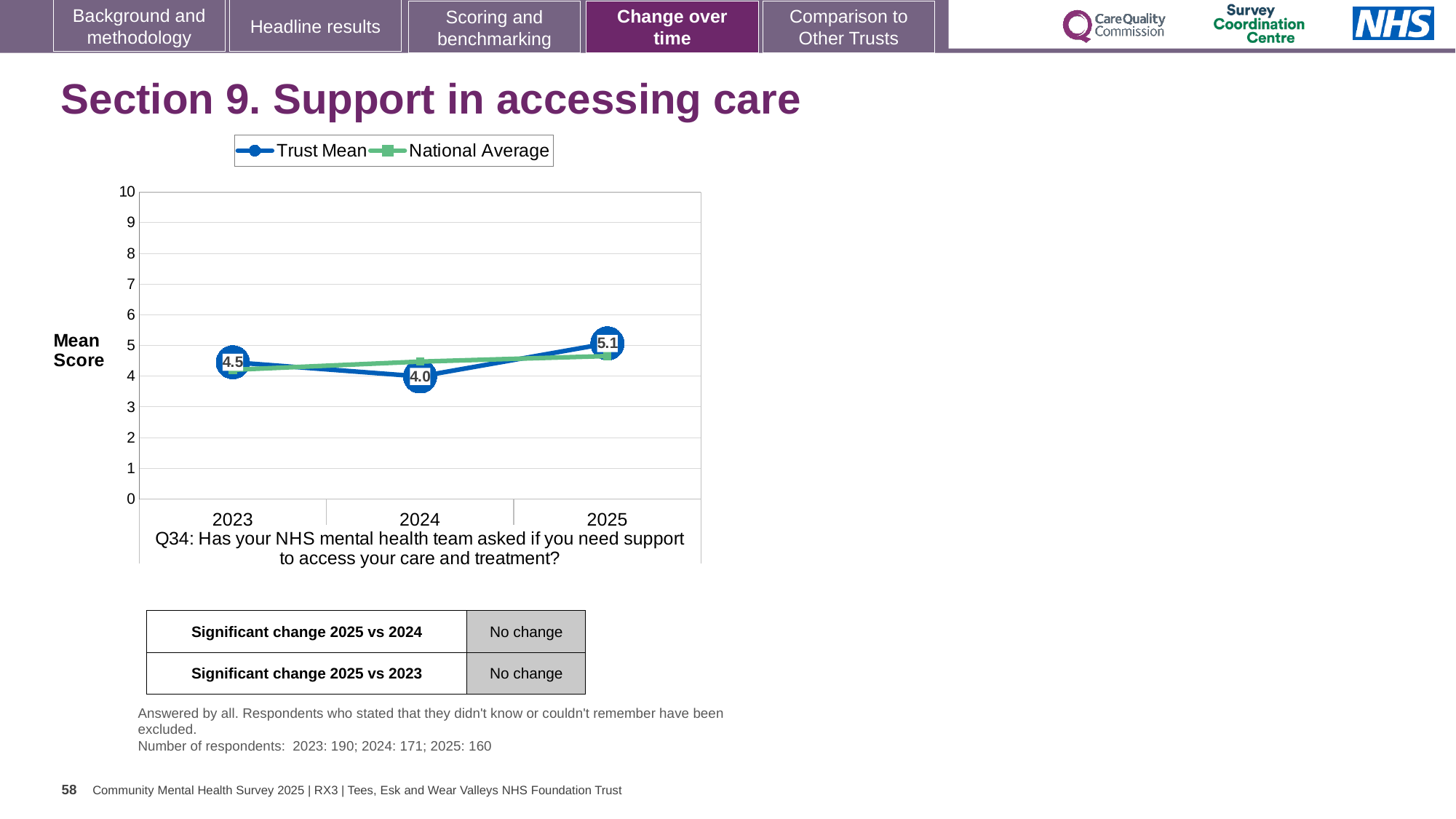
What is the Trust Mean value for 2024? 4.0 Does the Trust Mean rise or fall from 2024 to 2025? rise How many years are plotted on the x axis? 3 What is the Trust Mean value for 2023? 4.5 In which year is the Trust Mean lowest? 2024 Is the National Average value for 2025 greater or less than 5? less Which year has the larger Trust Mean, 2023 or 2025? 2025 In which year is the Trust Mean highest? 2025 What kind of chart is shown on the slide? line chart How many series does the legend list? 2 What is the Trust Mean value for 2025? 5.1 What is the difference between the Trust Mean in 2025 and in 2024? 1.1